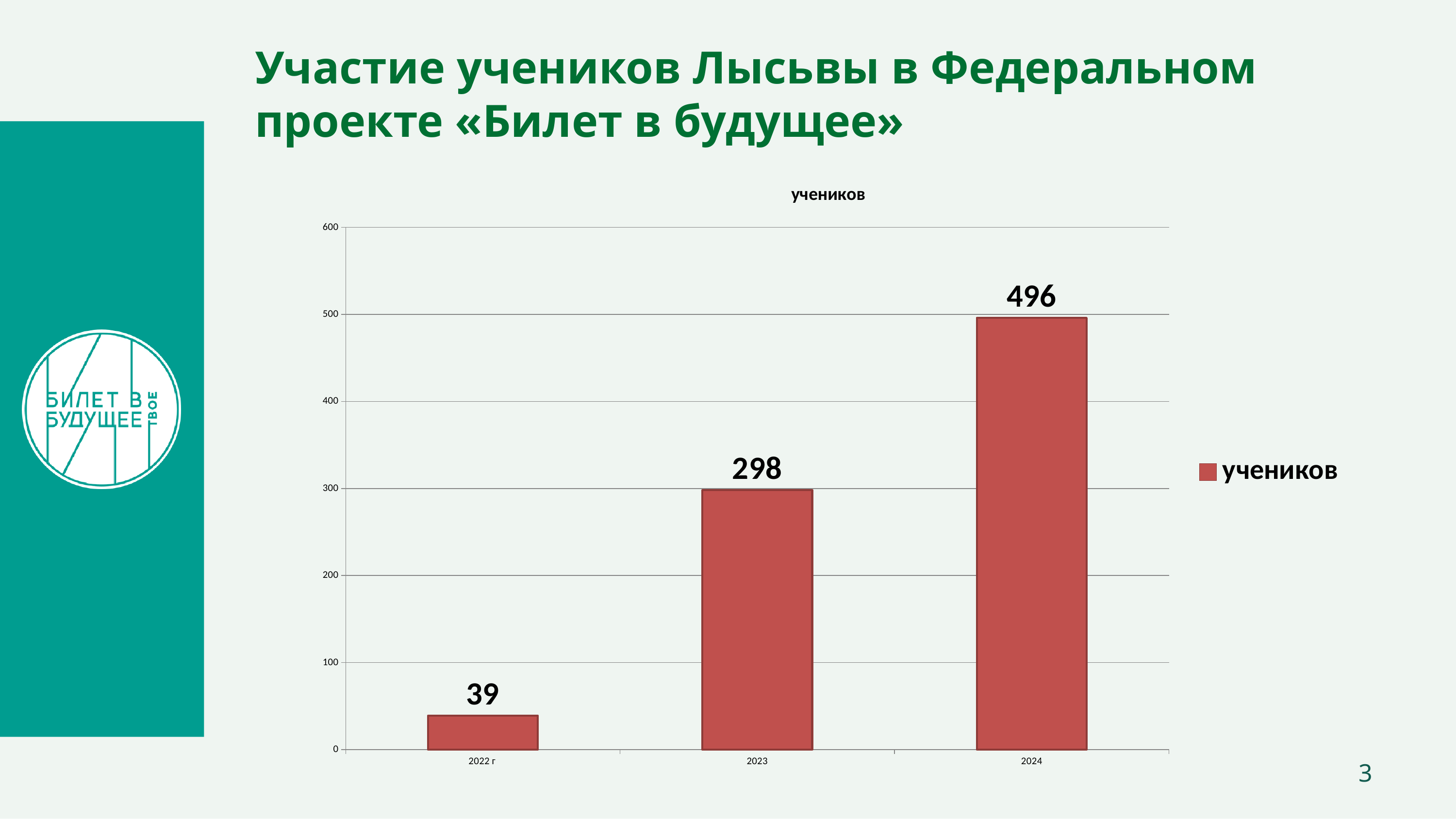
What is the difference between the values for 2024 and 2023? 198 Which is larger, the value for 2023 or the value for 2022 г? 2023 What is the difference between the values for 2023 and 2022 г? 259 What is the value for 2023? 298 What is the value for 2022 г? 39 Do the values rise or fall from 2022 г to 2024? rise Which year has the highest value? 2024 Which year has the lowest value? 2022 г What kind of chart is shown on the slide? bar chart How many series does the legend list? 1 What is the value for 2024? 496 How many categories are shown on the x axis? 3